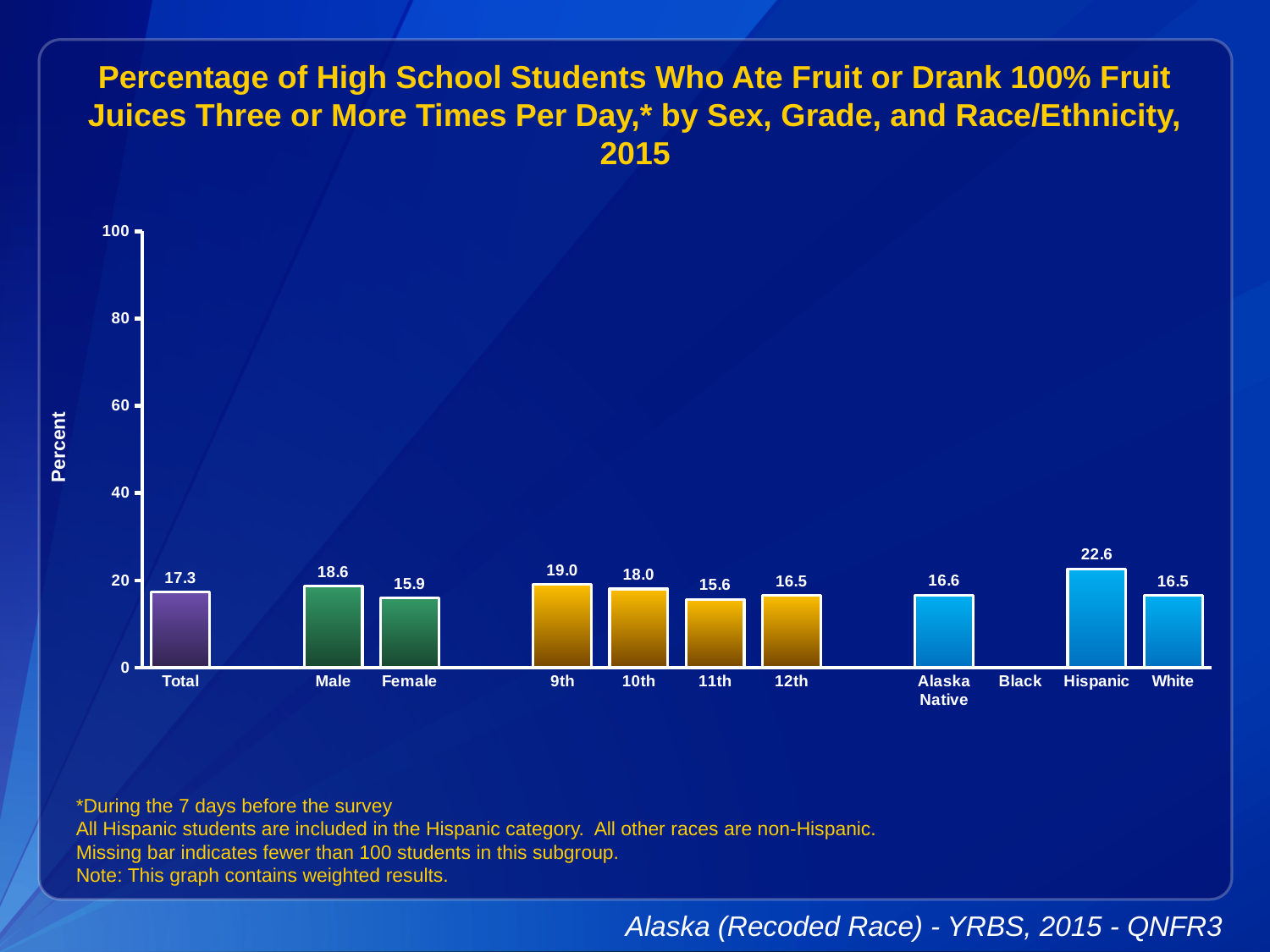
Is the value for Alaska Native greater or less than 20? less Which category has the highest value? Hispanic What is the value for 11th grade students? 15.6 What is the value for Hispanic students? 22.6 Which category has the lowest value among the bars shown? 11th Which is larger, the value for 9th grade or the value for 12th grade? 9th What is the value for Total? 17.3 What is the label on the y axis? Percent How many bars are plotted on the chart? 10 What is the difference between the Male and Female values? 2.7 What kind of chart is shown? bar chart Which category has no bar shown? Black